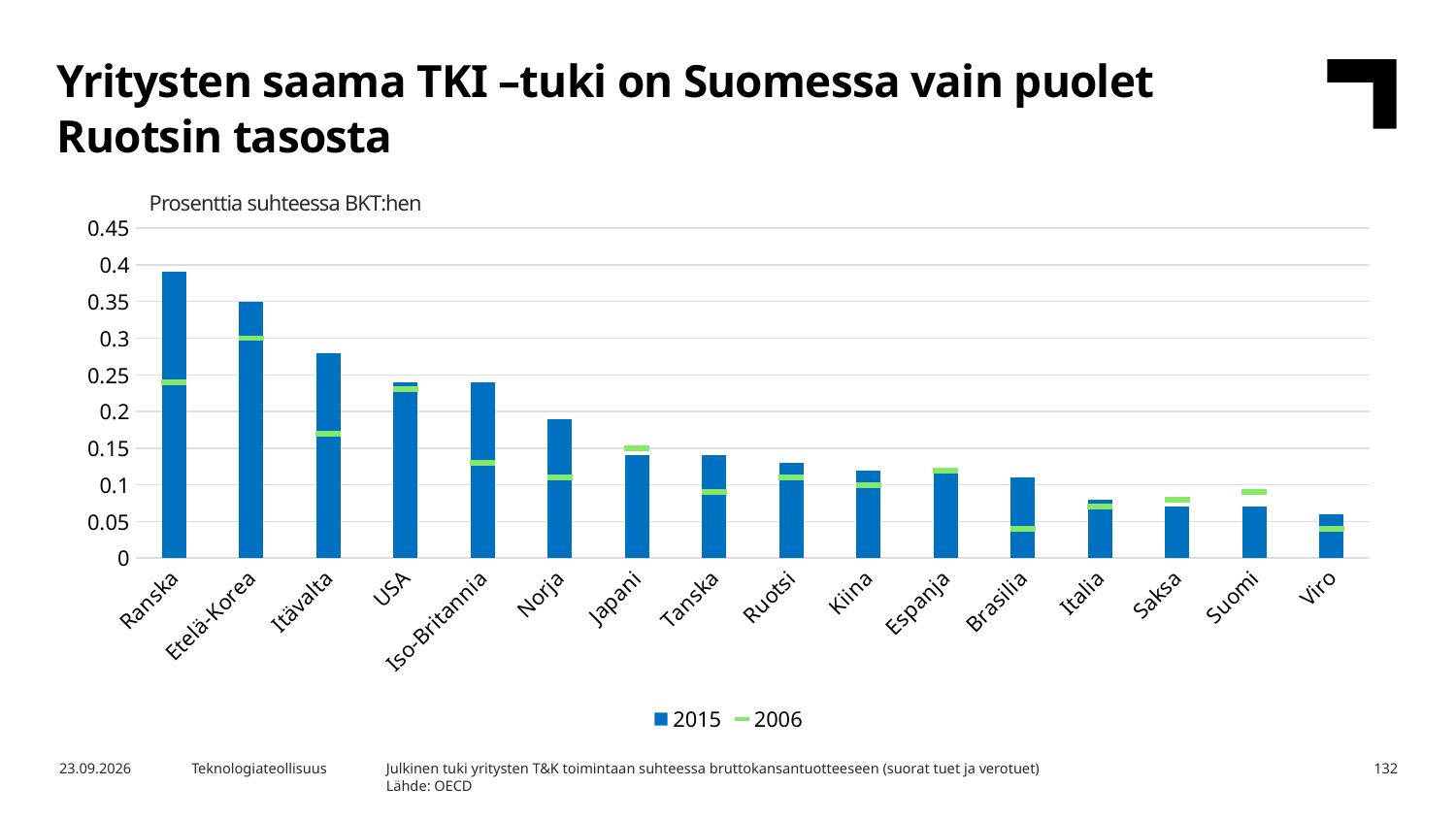
Which has the larger 2015 value, Ranska or Etelä-Korea? Ranska How many countries are shown on the x axis of the chart? 16 Do the 2015 values generally rise or fall from left to right along the x axis? fall Which country has the highest 2015 value in the chart? Ranska Is the 2015 value for Itävalta greater or less than 0.25? greater For Suomi, which year has the higher value, 2015 or 2006? 2006 Is the 2015 value for Ranska greater or less than 0.35? greater Which country has the lowest 2015 value in the chart? Viro Is the 2015 value for Suomi greater or less than 0.1? less What kind of chart is shown on the slide? bar chart Which has the larger 2015 value, Itävalta or Norja? Itävalta How many series does the chart legend list? 2